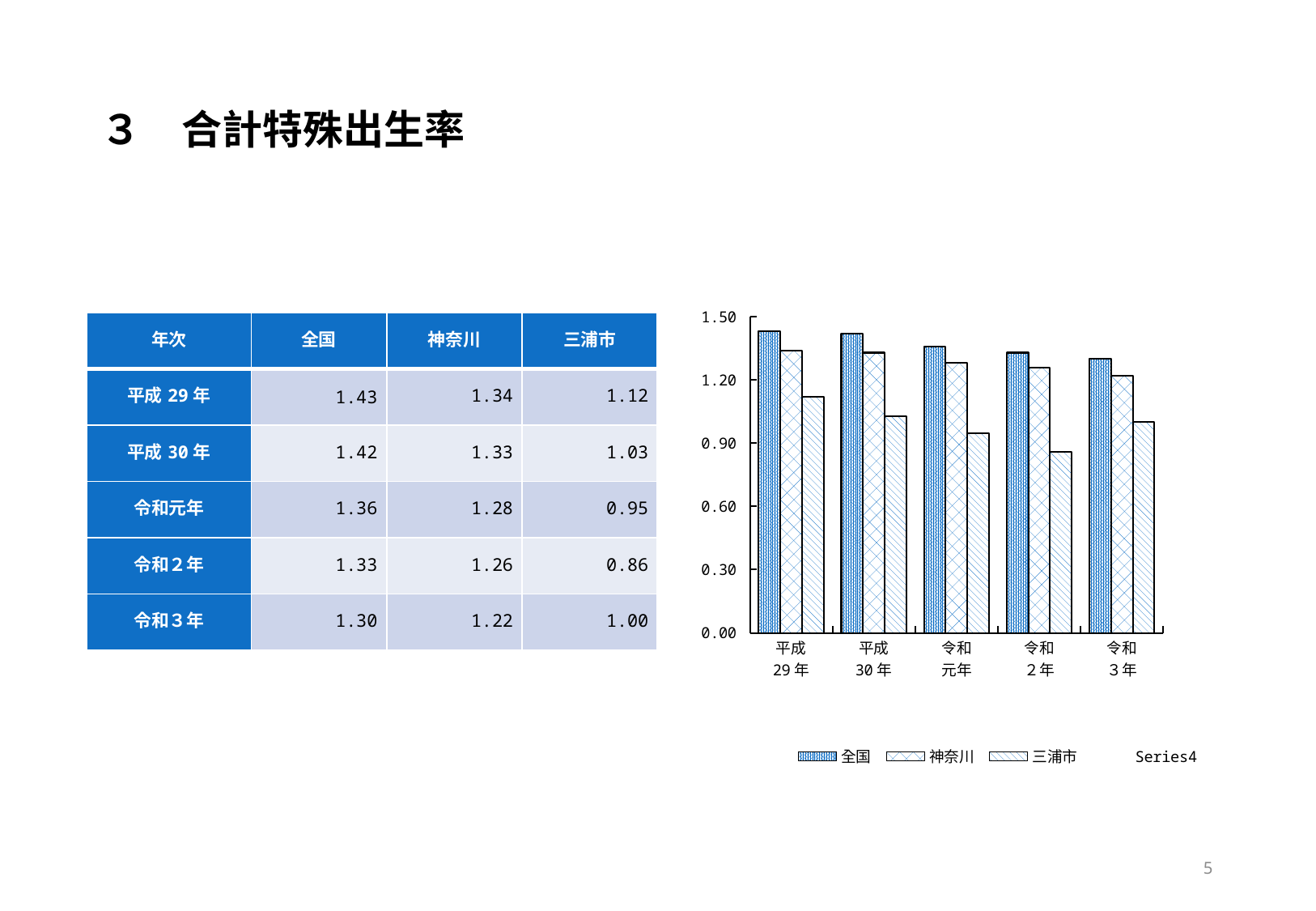
What kind of chart is shown on the slide? bar chart What is the value for 全国 in 平成29年? 1.43 What is the value for 三浦市 in 令和2年? 0.86 Do the 全国 values rise or fall from 平成29年 to 令和3年? fall How many entries does the chart legend list? 4 Is the value for 三浦市 in 令和2年 greater or less than 0.90? less In which year is the 三浦市 value lowest? 令和2年 In which year is the 三浦市 value highest? 平成29年 Which is larger in 令和3年, the 神奈川 value or the 三浦市 value? 神奈川 How many year categories are plotted on the x axis of the chart? 5 What is the difference between the 全国 and 三浦市 values in 平成29年? 0.31 What is the value for 神奈川 in 令和元年? 1.28